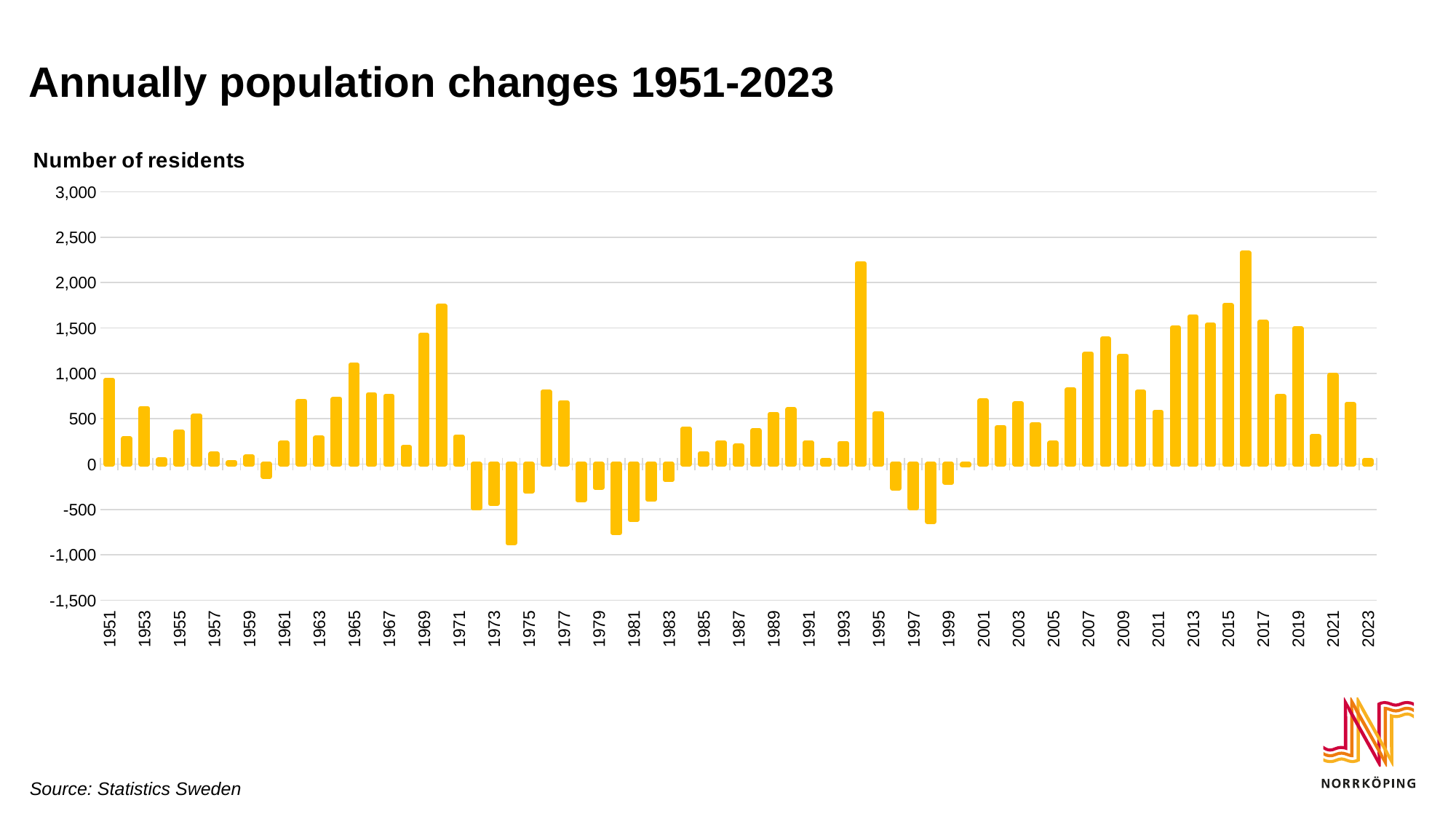
Is the value for 1965 greater or less than 1,000? greater Which year has the larger value, 2007 or 2013? 2013 Is the value for 2007 greater or less than 1,000? greater What is the label on the vertical axis of the chart? Number of residents What is the title of the chart? Annually population changes 1951-2023 Which year has the larger value, 1951 or 1953? 1951 Is the value for 1951 greater or less than 1,000? less Between 2005 and 2013, do the values generally rise or fall? rise How many bars (years) are plotted in the chart? 73 What kind of chart is shown on the slide? bar chart